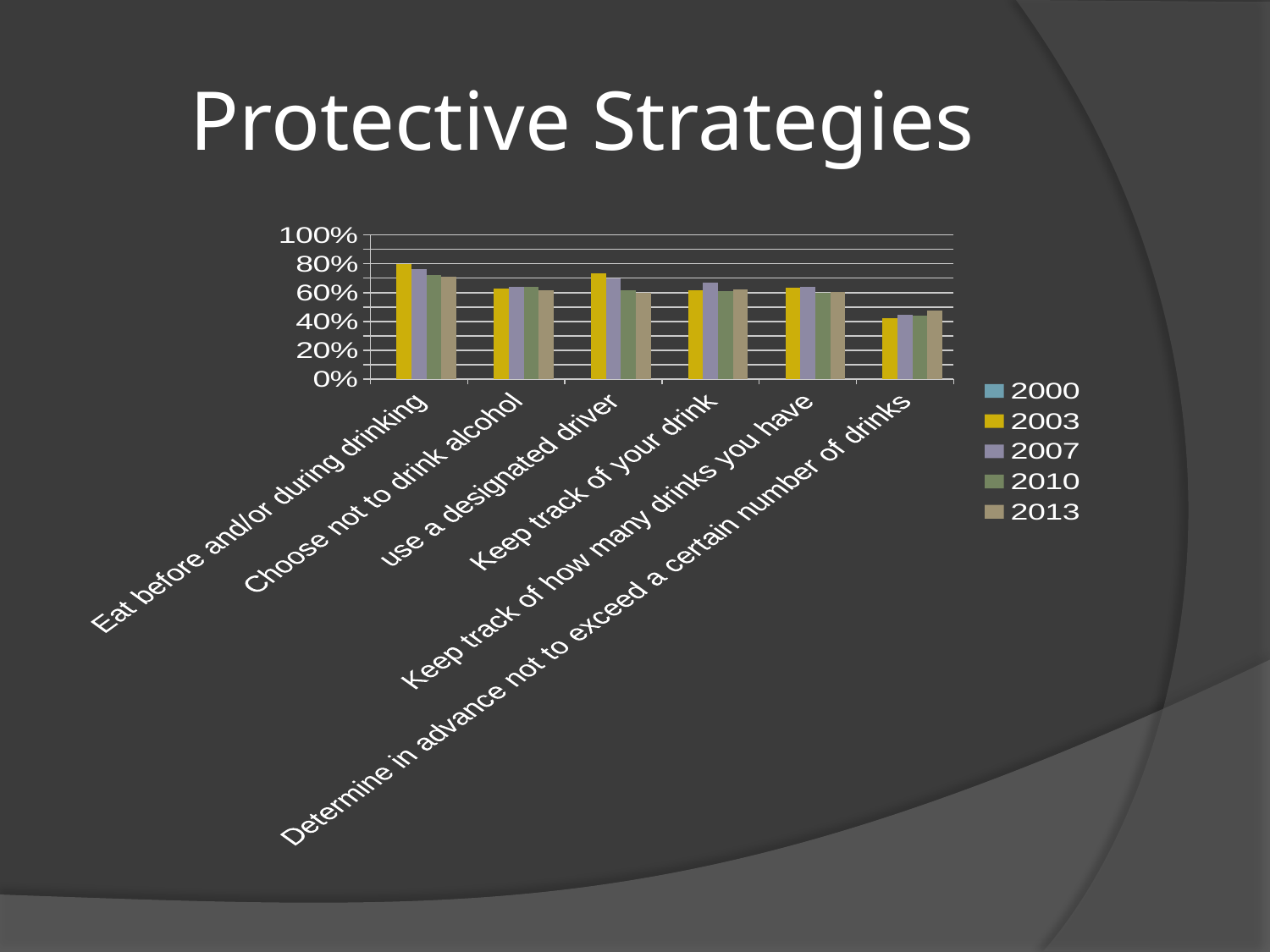
Which is larger: the 2003 value for 'Eat before and/or during drinking' or the 2003 value for 'Determine in advance not to exceed a certain number of drinks'? Eat before and/or during drinking For 'use a designated driver', do the values rise or fall from 2003 to 2013? fall Is the 2003 value for 'Eat before and/or during drinking' greater or less than 60%? greater What is the title of the slide containing the chart? Protective Strategies Is the 2003 value for 'Determine in advance not to exceed a certain number of drinks' greater or less than 60%? less What kind of chart is shown on the slide? bar chart Is the 2013 value for 'Determine in advance not to exceed a certain number of drinks' greater or less than 60%? less Which strategy has the highest 2003 value? Eat before and/or during drinking How many series does the legend list? 5 Which strategy has the lowest 2003 value? Determine in advance not to exceed a certain number of drinks How many categories (protective strategies) are shown on the x axis? 6 Which years are listed in the legend? 2000, 2003, 2007, 2010, 2013